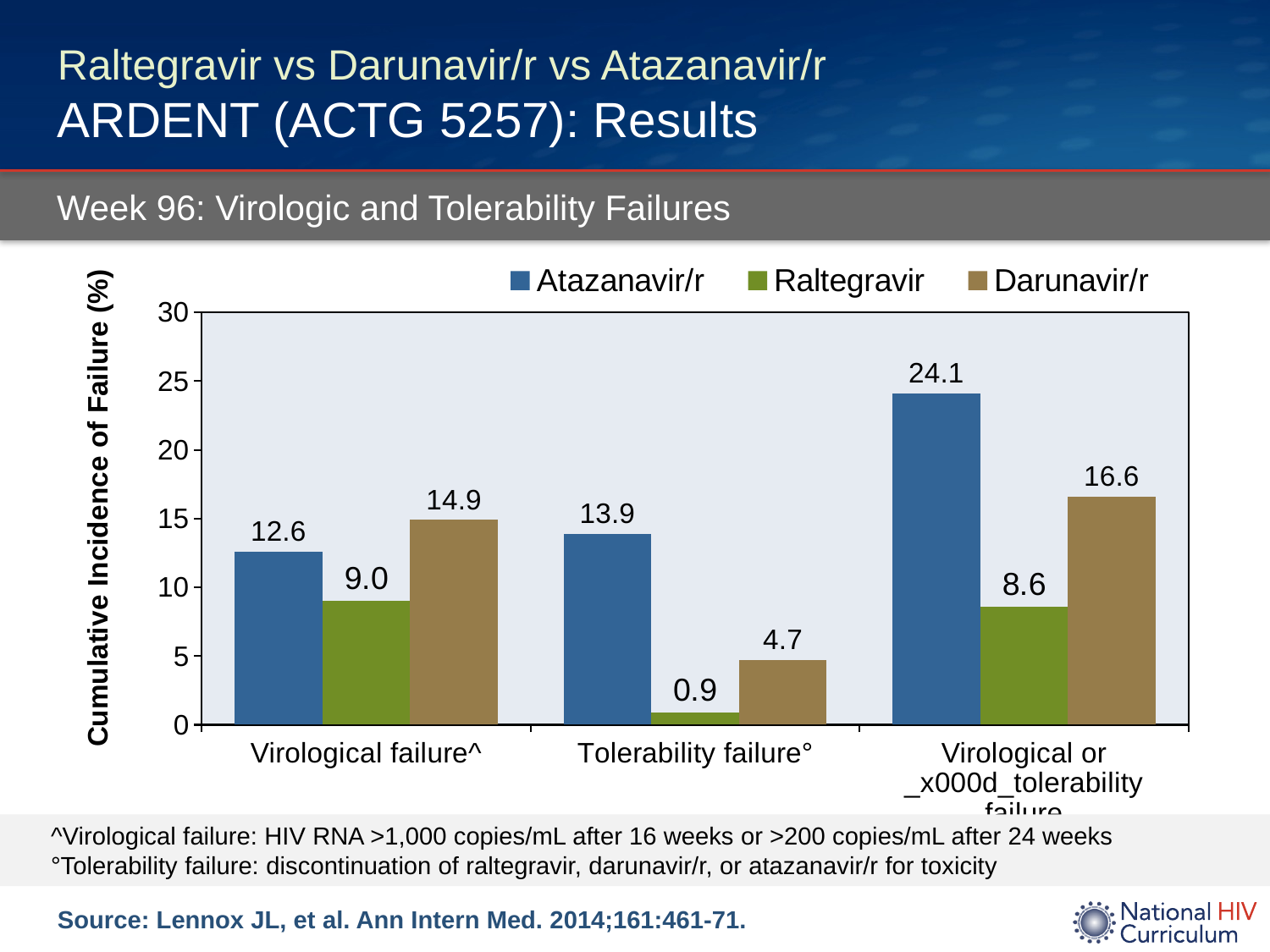
What is the cumulative incidence of virological failure for Atazanavir/r? 12.6 Which is larger for tolerability failure: the Atazanavir/r value or the Darunavir/r value? Atazanavir/r Which treatment has the lowest cumulative incidence of tolerability failure? Raltegravir Which treatment has the highest cumulative incidence of virological or tolerability failure? Atazanavir/r What is the value for Darunavir/r in the virological or tolerability failure category? 16.6 Is the value for Atazanavir/r in the virological or tolerability failure category greater or less than 20? greater How many failure categories are shown on the x axis? 3 What is the difference between the Darunavir/r and Raltegravir values for virological failure? 5.9 What is the cumulative incidence of tolerability failure for Raltegravir? 0.9 What is the label of the y axis? Cumulative Incidence of Failure (%) What kind of chart is shown on the slide? Bar chart How many series does the legend list? 3